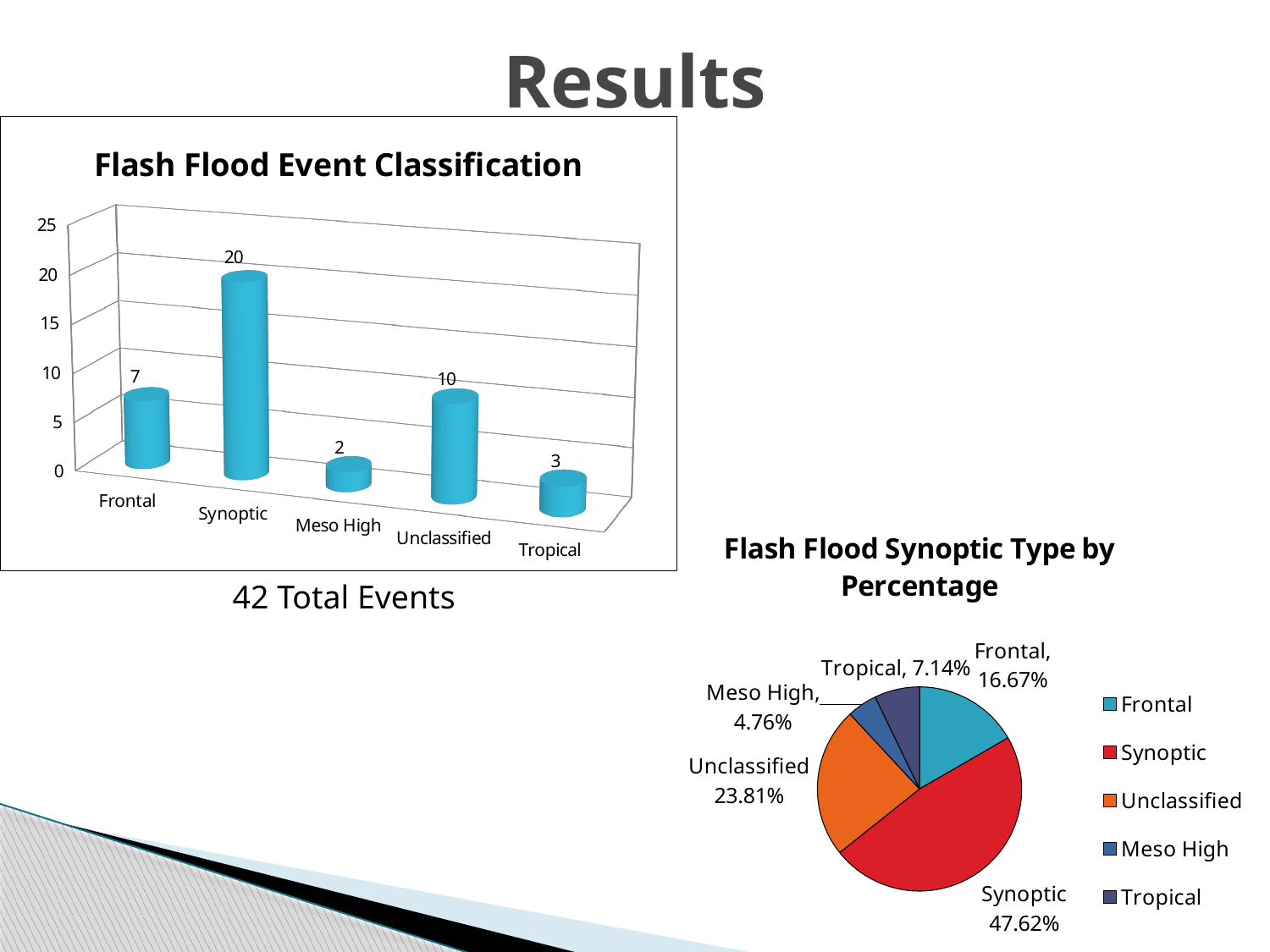
How many categories are shown in the 'Flash Flood Event Classification' chart? 5 How many entries does the legend of the 'Flash Flood Synoptic Type by Percentage' chart list? 5 What kind of chart is 'Flash Flood Event Classification'? Bar chart In the 'Flash Flood Event Classification' chart, which category has the highest value? Synoptic In the 'Flash Flood Event Classification' chart, which is larger, the value for Frontal or the value for Tropical? Frontal In the 'Flash Flood Event Classification' chart, what is the value for Unclassified? 10 In the 'Flash Flood Synoptic Type by Percentage' chart, what share does Unclassified have? 23.81% In the 'Flash Flood Event Classification' chart, which category has the lowest value? Meso High In the 'Flash Flood Event Classification' chart, what is the value for Synoptic? 20 In the 'Flash Flood Event Classification' chart, what is the difference between the values for Synoptic and Frontal? 13 What kind of chart is 'Flash Flood Synoptic Type by Percentage'? Pie chart In the 'Flash Flood Synoptic Type by Percentage' chart, what share does Meso High have? 4.76%